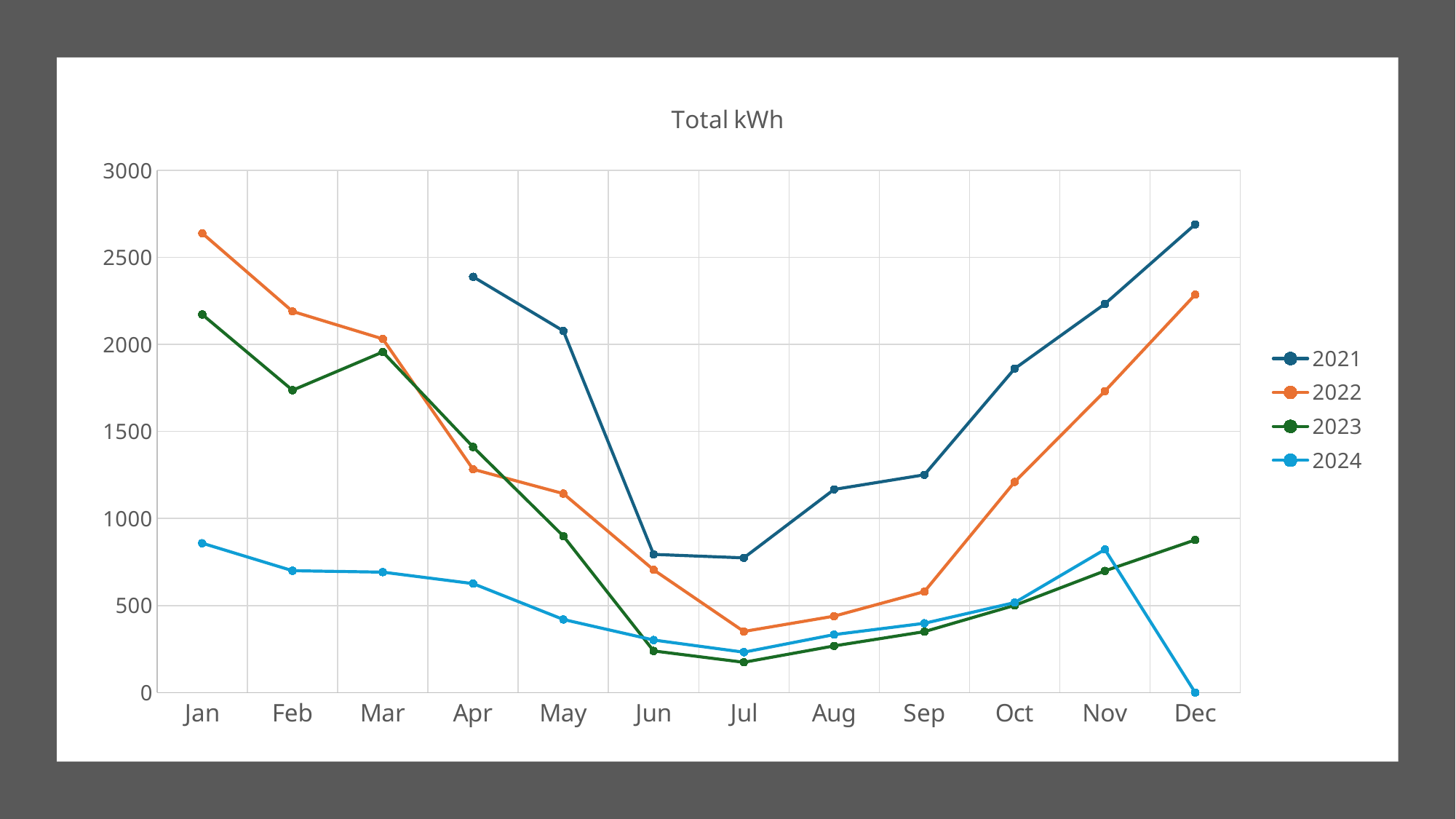
Is the value for 2024 in Jan greater or less than 1000? less In which month does the 2021 series reach its highest value? Dec How many months are shown on the x axis? 12 In which month does the 2022 series reach its highest value? Jan Which series has the lowest value in Jan? 2024 What is the title of the chart? Total kWh What kind of chart is shown on the slide? line chart Is the value for 2021 in Dec greater or less than 2500? greater In which month does the 2022 series reach its lowest value? Jul How many series does the legend list? 4 In Jan, which is larger: the 2022 value or the 2023 value? 2022 Does the 2022 series rise or fall from Jul to Dec? rise